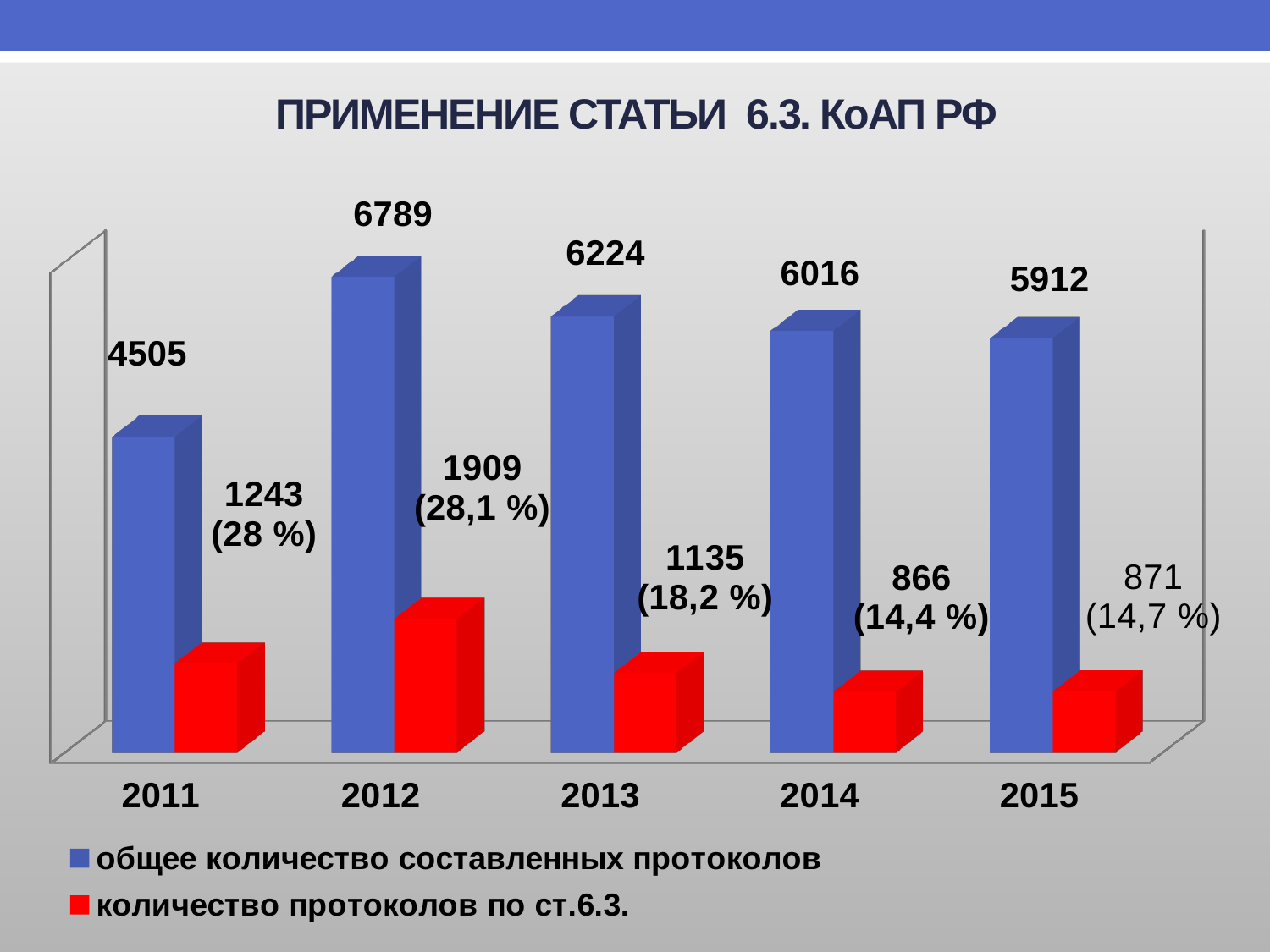
How many years are shown on the x axis? 5 Which year has the larger value of "общее количество составленных протоколов", 2013 or 2014? 2013 In which year is "количество протоколов по ст.6.3." the lowest? 2014 How many series does the legend list? 2 What is the difference between "количество протоколов по ст.6.3." in 2012 and in 2011? 666 What kind of chart is shown on the slide? bar chart What is the value of "общее количество составленных протоколов" for 2012? 6789 What percentage is shown next to the "количество протоколов по ст.6.3." value for 2015? 14,7 % In which year is "общее количество составленных протоколов" the lowest? 2011 What is the value of "количество протоколов по ст.6.3." for 2013? 1135 What is the difference between "общее количество составленных протоколов" in 2012 and in 2011? 2284 In which year is "общее количество составленных протоколов" the highest? 2012